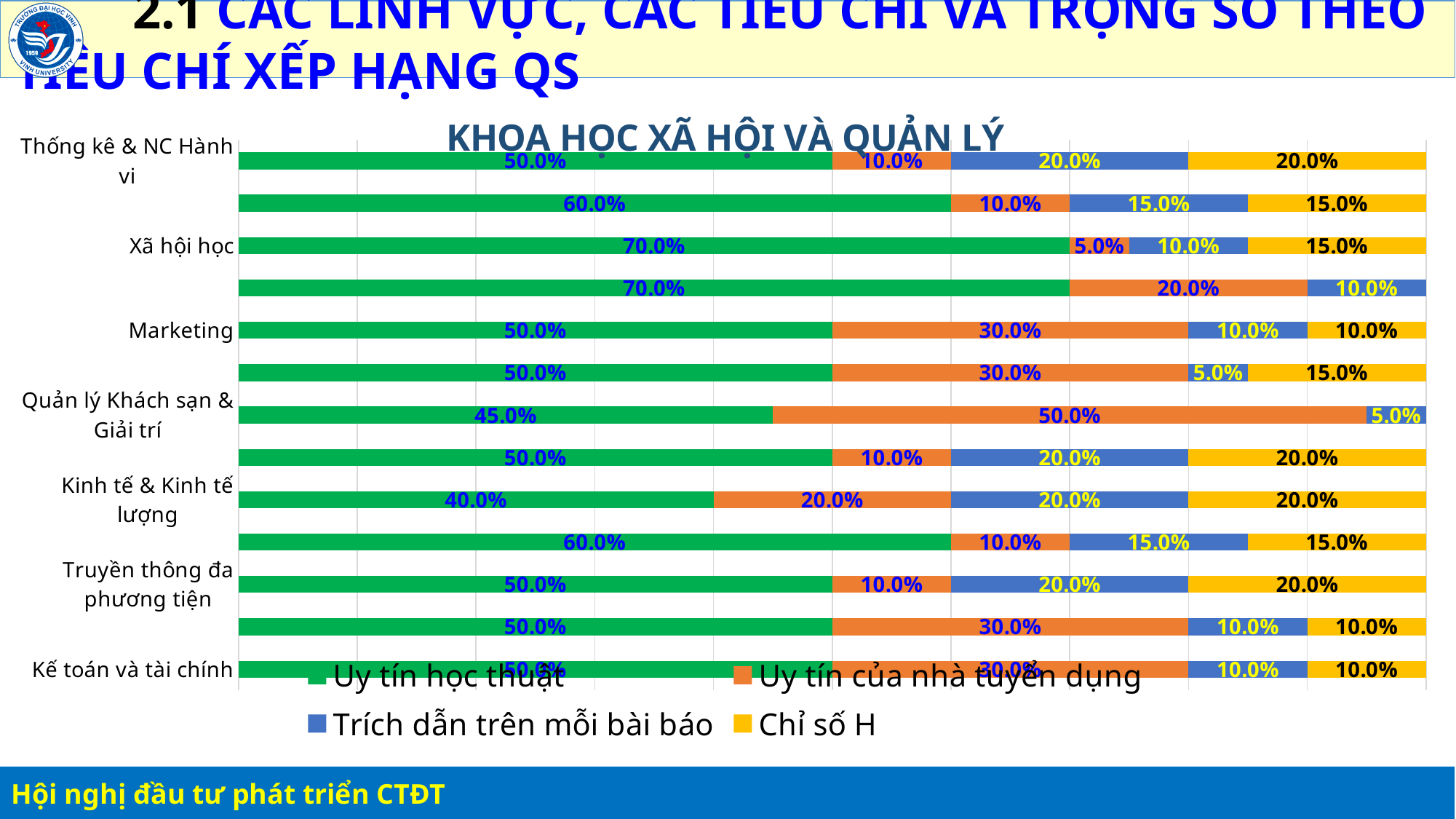
Which has a larger Uy tín học thuật value, Xã hội học or Marketing? Xã hội học What is the total of the stacked bar for Thống kê & NC Hành vi? 100.0% What is the value of Chỉ số H for Kinh tế & Kinh tế lượng? 20.0% What is the value of Uy tín học thuật for Kinh tế & Kinh tế lượng? 40.0% What is the title of the chart? KHOA HỌC XÃ HỘI VÀ QUẢN LÝ What is the value of Uy tín học thuật for Xã hội học? 70.0% What is the difference between the Uy tín học thuật values for Xã hội học and Kinh tế & Kinh tế lượng? 30.0% What is the value of Trích dẫn trên mỗi bài báo for Marketing? 10.0% How many series does the chart legend list? 4 What is the value of Uy tín của nhà tuyển dụng for Quản lý Khách sạn & Giải trí? 50.0% Which series is shown in green in the legend? Uy tín học thuật What type of chart is shown on the slide? Stacked bar chart